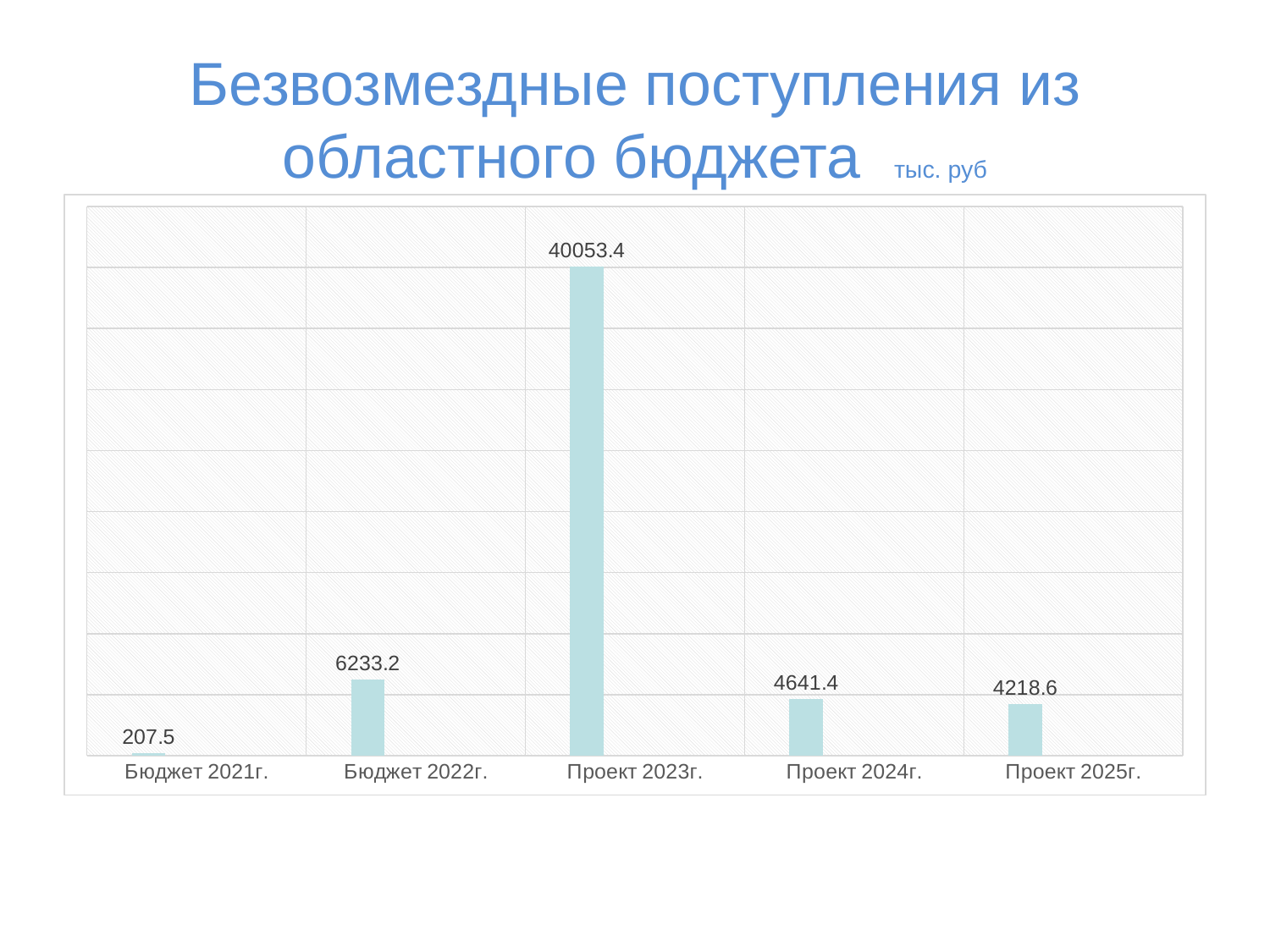
Do the values rise or fall from Проект 2023г. to Проект 2025г.? Fall What is the difference between the values for Бюджет 2022г. and Проект 2024г.? 1591.8 Which category has the highest value? Проект 2023г. What kind of chart is shown on the slide? Bar chart What is the value for Бюджет 2021г.? 207.5 Which is larger, the value for Бюджет 2022г. or the value for Проект 2025г.? Бюджет 2022г. What is the difference between the values for Проект 2024г. and Проект 2025г.? 422.8 Which category has the lowest value? Бюджет 2021г. What is the value for Проект 2025г.? 4218.6 What unit is given next to the chart title? тыс. руб What is the value for Проект 2023г.? 40053.4 How many categories are shown on the x axis? 5